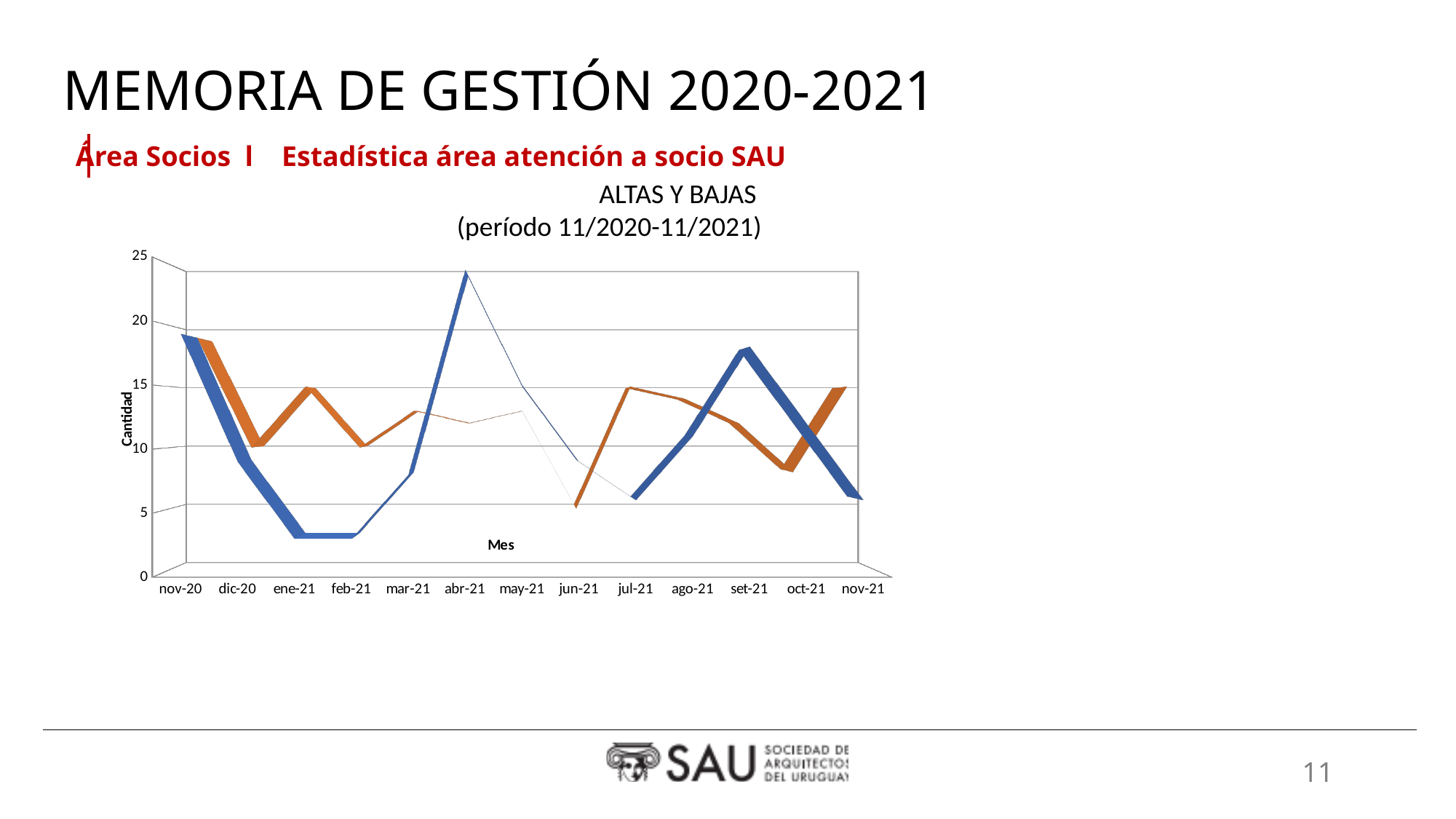
What is the label of the vertical axis of the chart? Cantidad Is the value of the orange line at jun-21 greater or less than 10? less What is the title of the chart? ALTAS Y BAJAS (período 11/2020-11/2021) What kind of chart is shown on the slide? line chart Does the blue line rise or fall from nov-20 to ene-21? fall Is the value of the blue line at abr-21 greater or less than 20? greater How many months are shown along the x axis of the chart? 13 In which month does the orange line reach its lowest value? jun-21 Is the value of the blue line at ene-21 greater or less than 5? less At abr-21, which line has the higher value, the blue line or the orange line? the blue line In which month does the blue line reach its highest value? abr-21 In which month does the orange line reach its highest value? nov-20